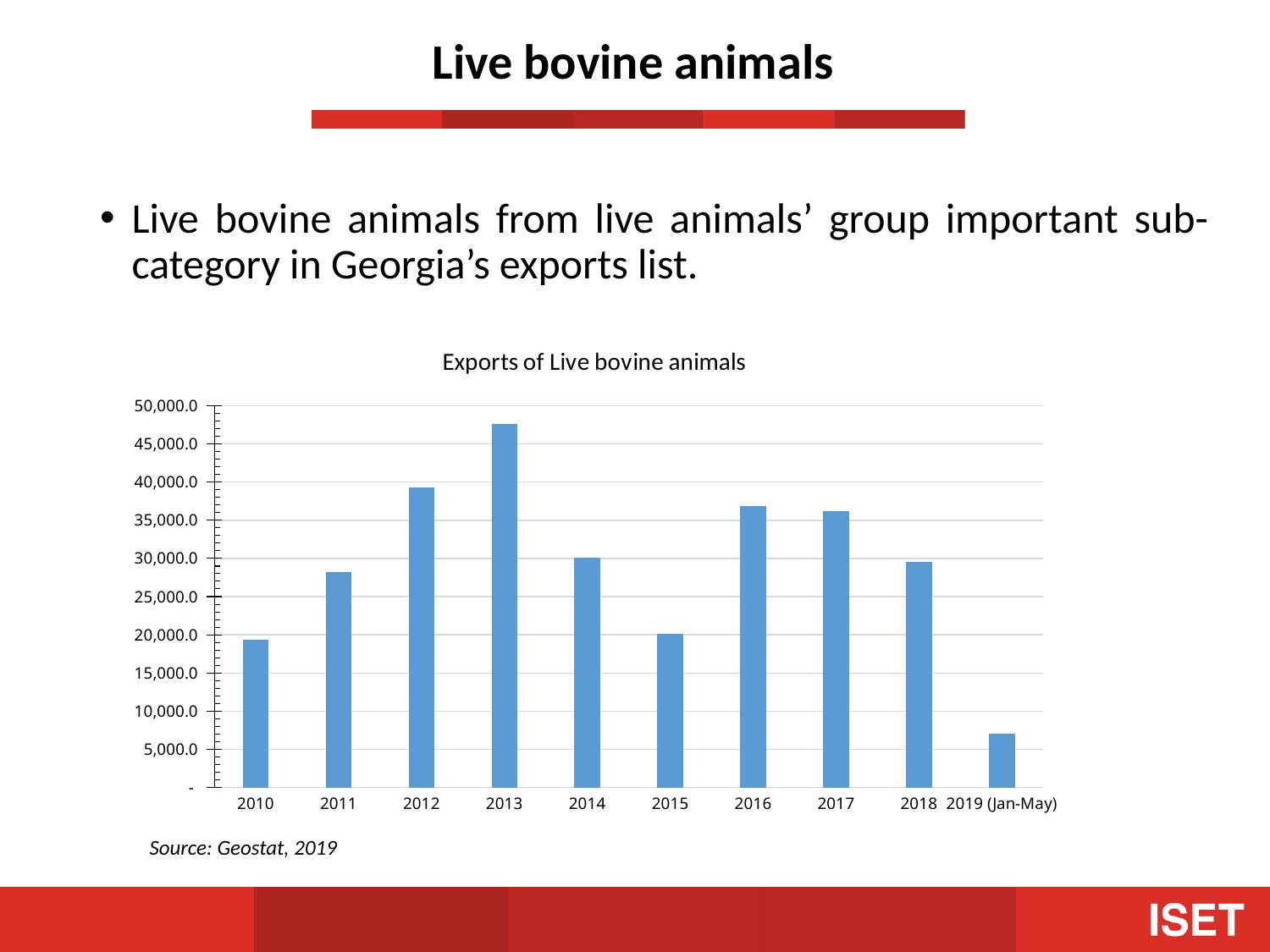
Which category has the lowest value in the chart? 2019 (Jan-May) What source is cited below the chart? Geostat, 2019 Is the value for 2011 greater or less than 25,000.0? greater Which year has the highest value for exports of live bovine animals? 2013 Which is larger, the value for 2012 or the value for 2014? 2012 What is the title of the chart? Exports of Live bovine animals Do the values rise or fall from 2010 to 2013? rise Is the value for 2013 greater or less than 45,000.0? greater Is the value for 2019 (Jan-May) greater or less than 10,000.0? less What kind of chart is shown on the slide? bar chart How many bars (years) are plotted in the chart? 10